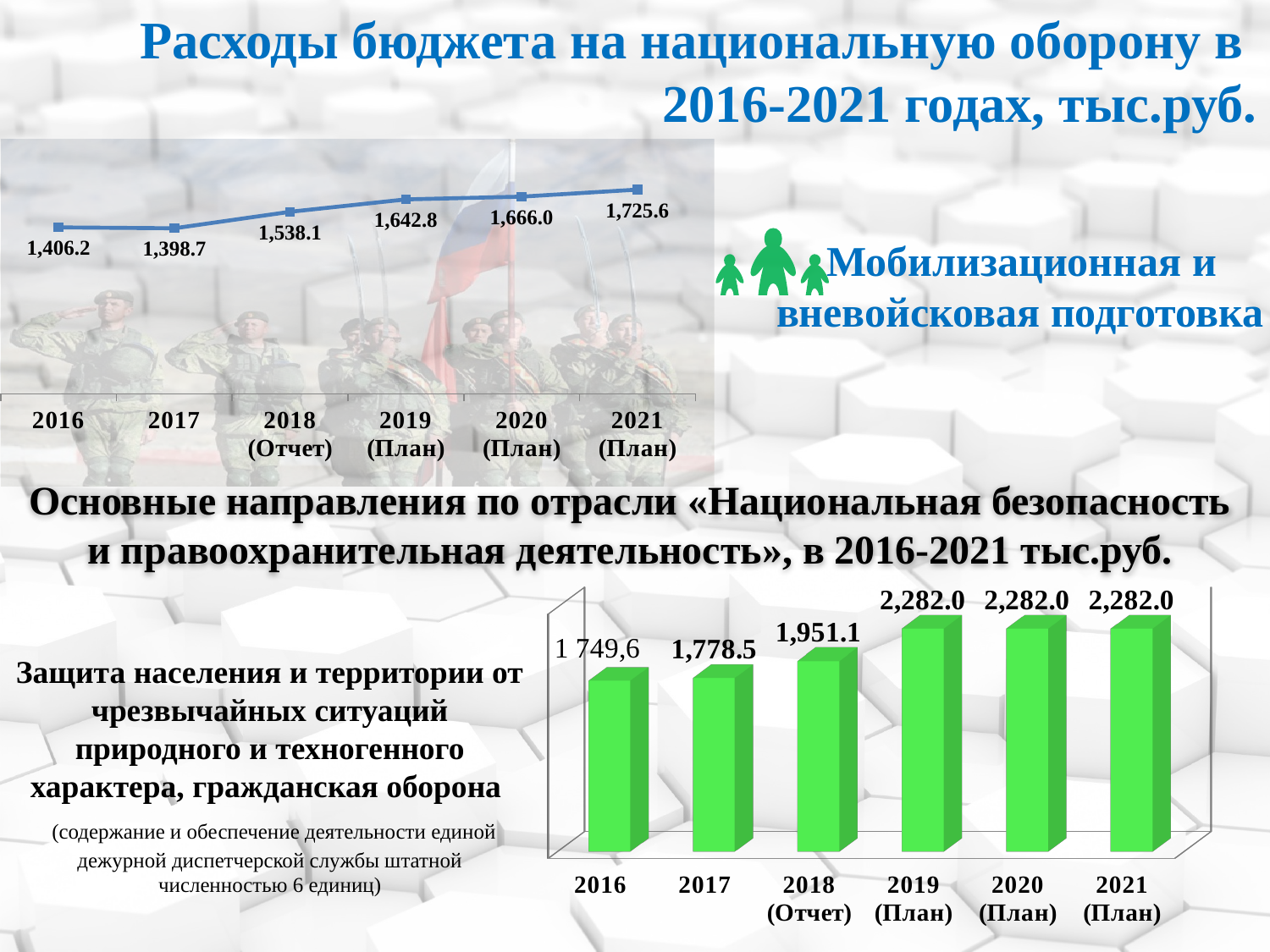
In the bottom bar chart, what is the value for 2017? 1,778.5 In the top line chart, what is the difference between the 2021 (План) value and the 2020 (План) value? 59.6 In the top line chart, which year has the lowest value? 2017 What type of chart is the top chart on the slide? line chart How many data points does the top line chart show? 6 In the top line chart, what is the value for 2019 (План)? 1,642.8 In the bottom bar chart, what is the value for 2018 (Отчет)? 1,951.1 In the bottom bar chart, what is the difference between the 2019 (План) value and the 2018 (Отчет) value? 330.9 What type of chart is the bottom chart on the slide? bar chart In the top line chart, which year has the highest value? 2021 (План) In the bottom bar chart, which is larger: the value for 2016 or the value for 2018 (Отчет)? 2018 (Отчет) In the top line chart, what is the value for 2016? 1,406.2